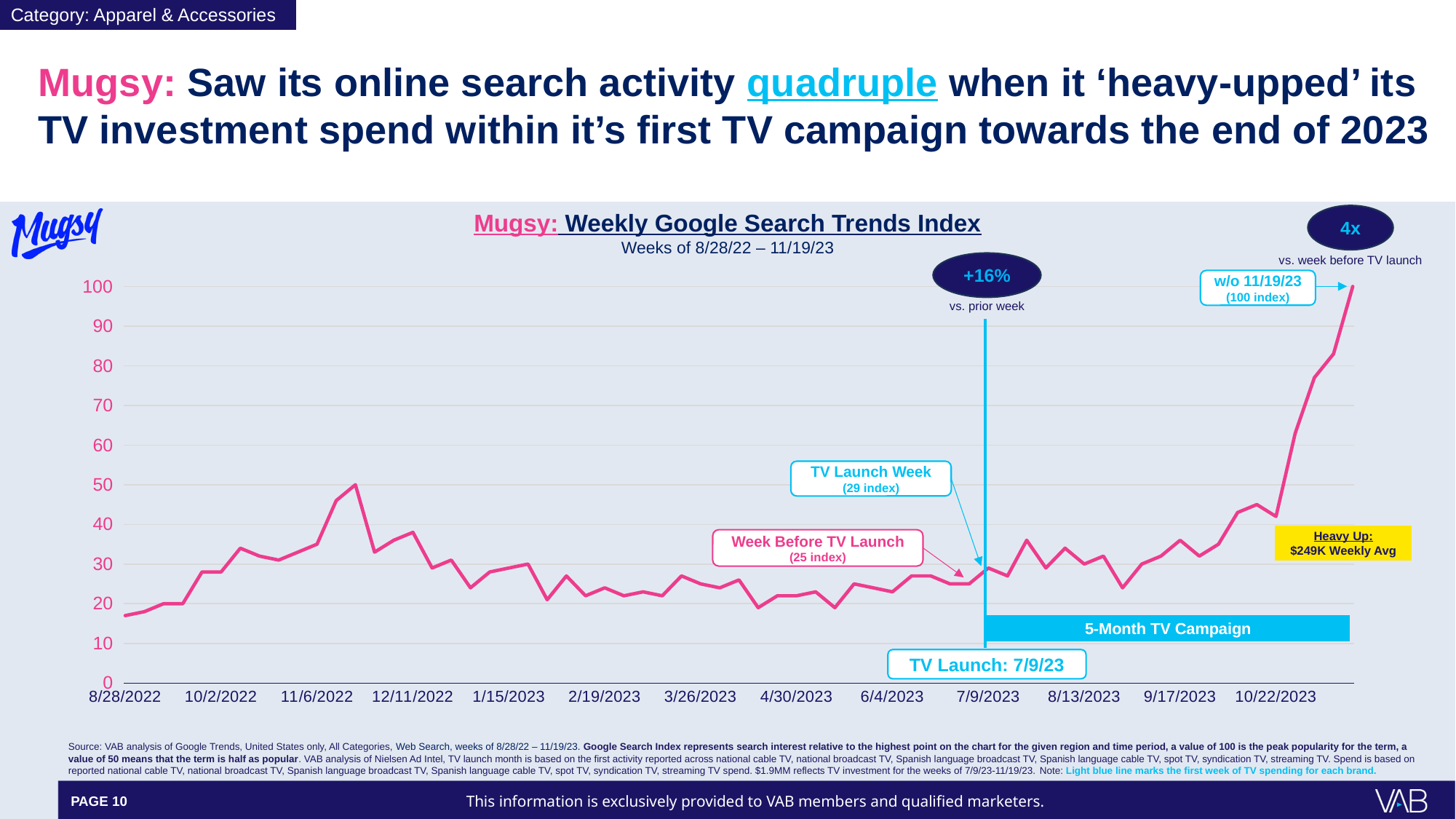
According to the chart annotation, what was the percentage change in the search index in the TV launch week vs. the prior week? +16% Is the search index value for 8/28/2022 greater or less than 20? less What was the Google Search Trends Index for Mugsy in the week of 11/19/23? 100 index Is the search index value for 4/30/2023 greater or less than 30? less What kind of chart is shown on the slide? line chart According to the chart annotation, by what multiple did the search index in the week of 11/19/23 exceed the week before TV launch? 4x What was the Google Search Trends Index for Mugsy in the TV Launch Week? 29 index What was the Google Search Trends Index for Mugsy in the Week Before TV Launch? 25 index By how many index points did the TV Launch Week exceed the Week Before TV Launch? 4 Which is larger, the index for the TV Launch Week or the Week Before TV Launch? TV Launch Week Which week has the highest search index value on the chart? w/o 11/19/23 Does the search index rise or fall between 9/17/2023 and the end of the chart? rise